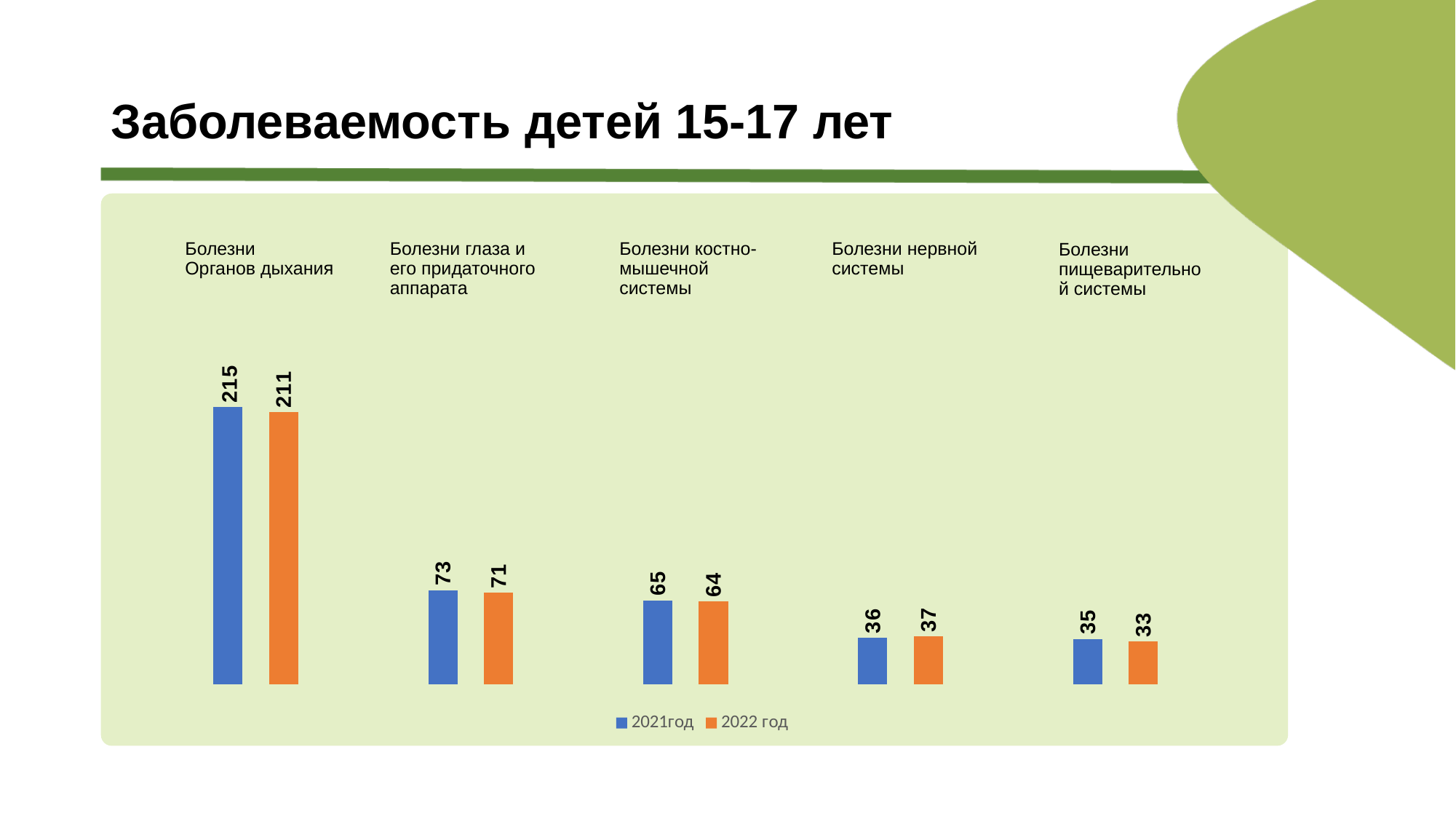
What is the value for Болезни глаза и его придаточного аппарата in 2021год? 73 Which is larger for Болезни нервной системы: the 2021год value or the 2022 год value? 2022 год What is the value for Болезни пищеварительной системы in 2022 год? 33 What kind of chart is shown on the slide? Bar chart What is the value for Болезни органов дыхания in 2021год? 215 Which category has the lowest value in 2021год? Болезни пищеварительной системы How many series does the legend list? 2 What is the difference between the 2021год and 2022 год values for Болезни органов дыхания? 4 How many categories are shown on the chart? 5 What is the value for Болезни нервной системы in 2022 год? 37 What is the difference between the 2021год values for Болезни глаза и его придаточного аппарата and Болезни костно-мышечной системы? 8 Which category has the highest value in 2022 год? Болезни органов дыхания